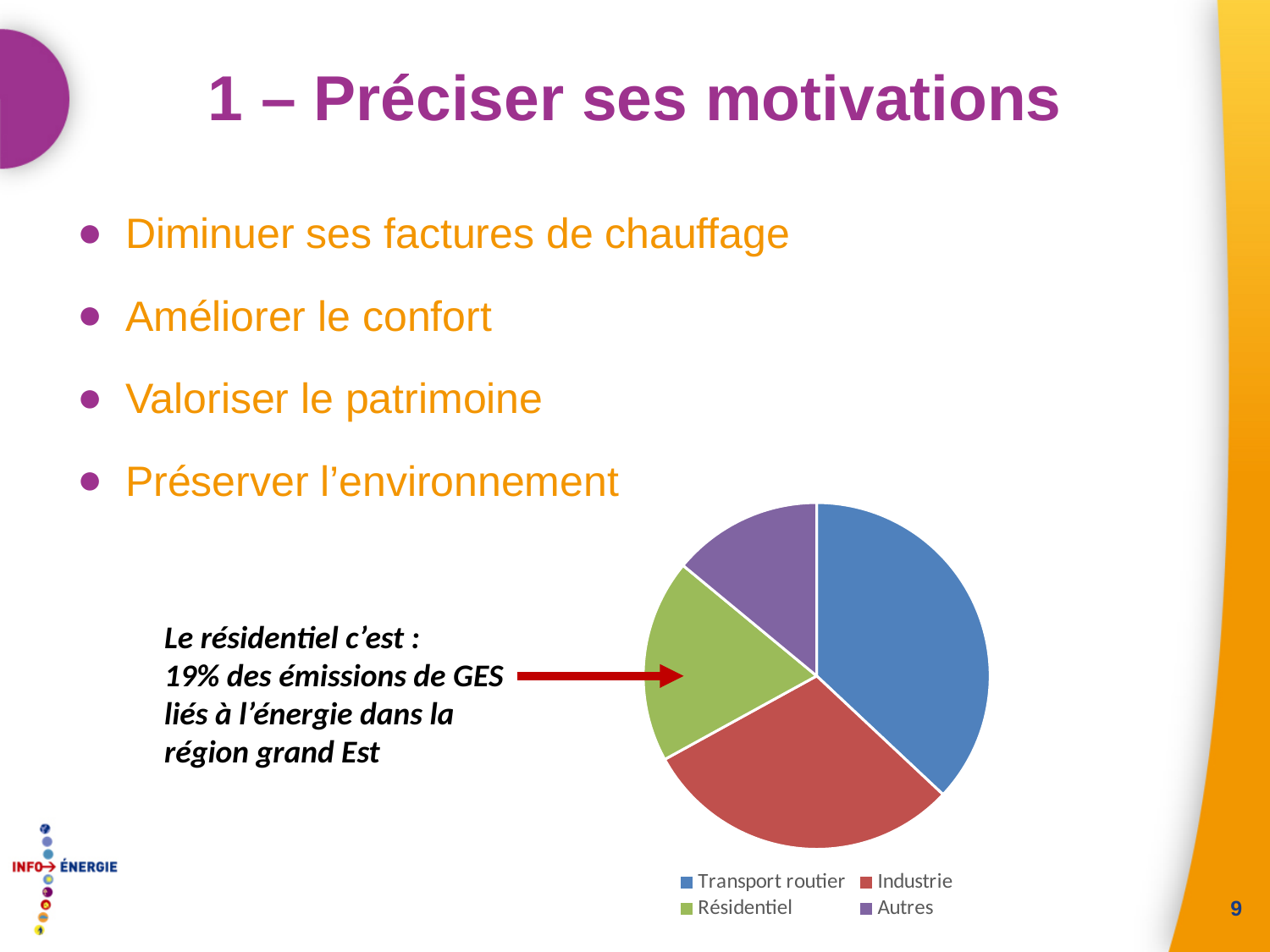
Which category has the largest slice in the pie chart? Transport routier Which slice is larger in the pie chart, Transport routier or Industrie? Transport routier Which category has the smallest slice in the pie chart? Autres Which slice is larger in the pie chart, Résidentiel or Autres? Résidentiel What colour is the Transport routier slice in the pie chart? blue How many slices does the pie chart have? 4 How many entries does the legend of the pie chart list? 4 What kind of chart is shown on the slide? pie chart According to the slide, what share of the pie does the Résidentiel slice represent? 19% Which legend entry is shown in green in the pie chart? Résidentiel Which slice is larger in the pie chart, Industrie or Résidentiel? Industrie